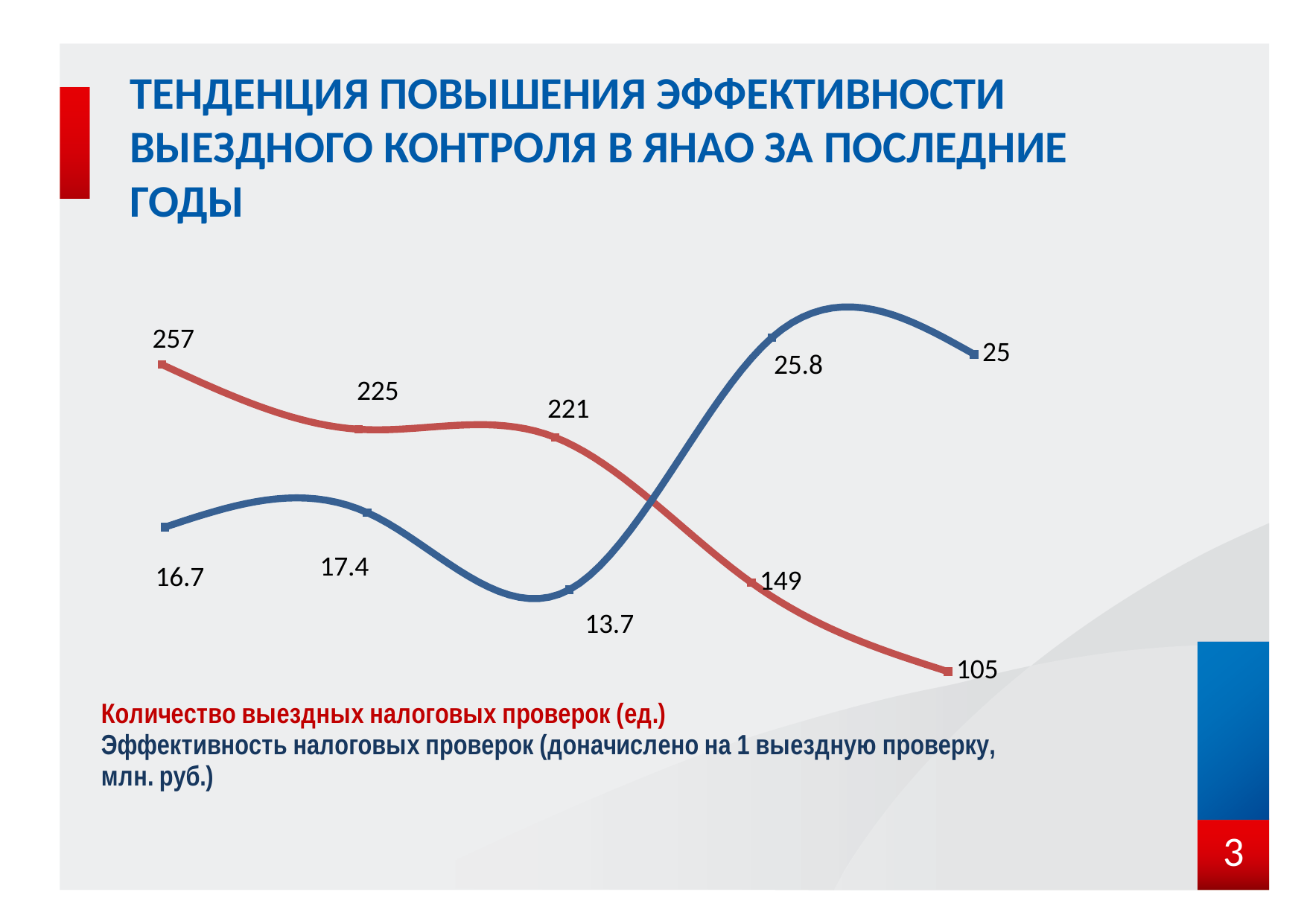
What is the lowest value on the red line (Количество выездных налоговых проверок)? 105 How many series does the chart legend list? 2 What is the first value of the red line (Количество выездных налоговых проверок)? 257 What is the highest value on the blue line (Эффективность налоговых проверок)? 25.8 What is the last value of the red line (Количество выездных налоговых проверок)? 105 What kind of chart is shown on the slide? line chart Does the red line (Количество выездных налоговых проверок) rise or fall from left to right? fall Which series is drawn in red? Количество выездных налоговых проверок (ед.) Which is larger on the blue line (Эффективность налоговых проверок): the second value or the fourth value? the fourth value (25.8) How many data points does the red line (Количество выездных налоговых проверок) have? 5 What is the difference between the first and last values of the red line (Количество выездных налоговых проверок)? 152 What is the third value of the blue line (Эффективность налоговых проверок)? 13.7